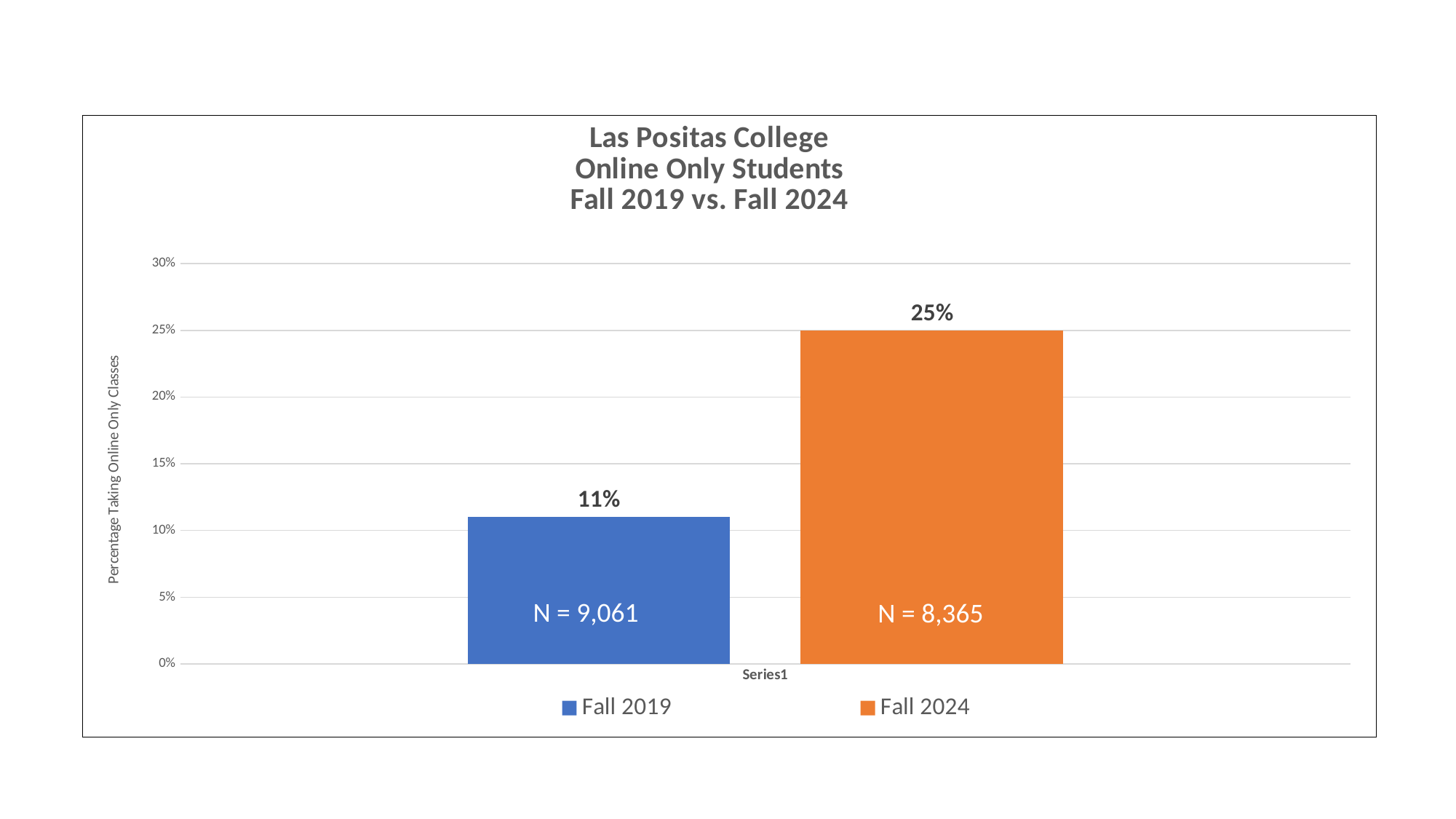
What is the N value shown on the Fall 2019 bar? N = 9,061 What is the label of the vertical axis? Percentage Taking Online Only Classes Which term has the higher percentage of online only students, Fall 2019 or Fall 2024? Fall 2024 What percentage of students were taking online only classes in Fall 2024? 25% What kind of chart is shown on the slide? Bar chart What percentage of students were taking online only classes in Fall 2019? 11% Is the value for Fall 2019 greater or less than 15%? less What is the N value shown on the Fall 2024 bar? N = 8,365 What is the difference in percentage points between Fall 2024 and Fall 2019? 14 How many series does the legend list? 2 Is the value for Fall 2024 greater or less than 20%? greater Which series has the lowest percentage of online only students? Fall 2019